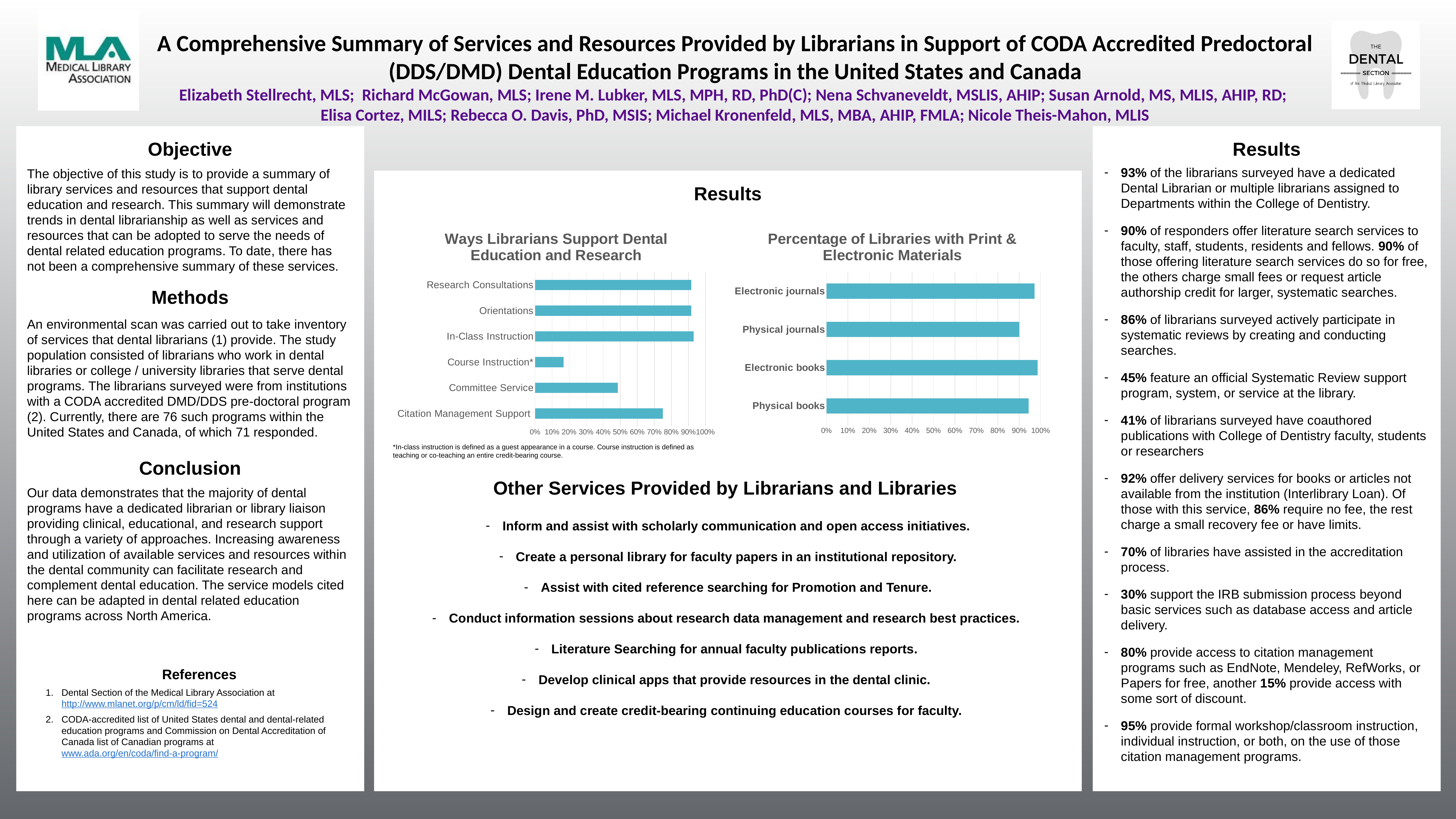
In the "Percentage of Libraries with Print & Electronic Materials" chart, which is larger: Electronic books or Physical journals? Electronic books In the "Ways Librarians Support Dental Education and Research" chart, is the value for Course Instruction* greater or less than 20%? less In the "Ways Librarians Support Dental Education and Research" chart, which category has the lowest value? Course Instruction* In the "Ways Librarians Support Dental Education and Research" chart, which is larger: Committee Service or Citation Management Support? Citation Management Support How many categories are shown in the "Ways Librarians Support Dental Education and Research" chart? 6 In the "Ways Librarians Support Dental Education and Research" chart, is the value for Citation Management Support greater or less than 70%? greater What is the title of the chart on the right side of the Results section? Percentage of Libraries with Print & Electronic Materials In the "Percentage of Libraries with Print & Electronic Materials" chart, is the value for Electronic journals greater or less than 90%? greater What type of chart is "Ways Librarians Support Dental Education and Research"? bar chart How many categories are shown in the "Percentage of Libraries with Print & Electronic Materials" chart? 4